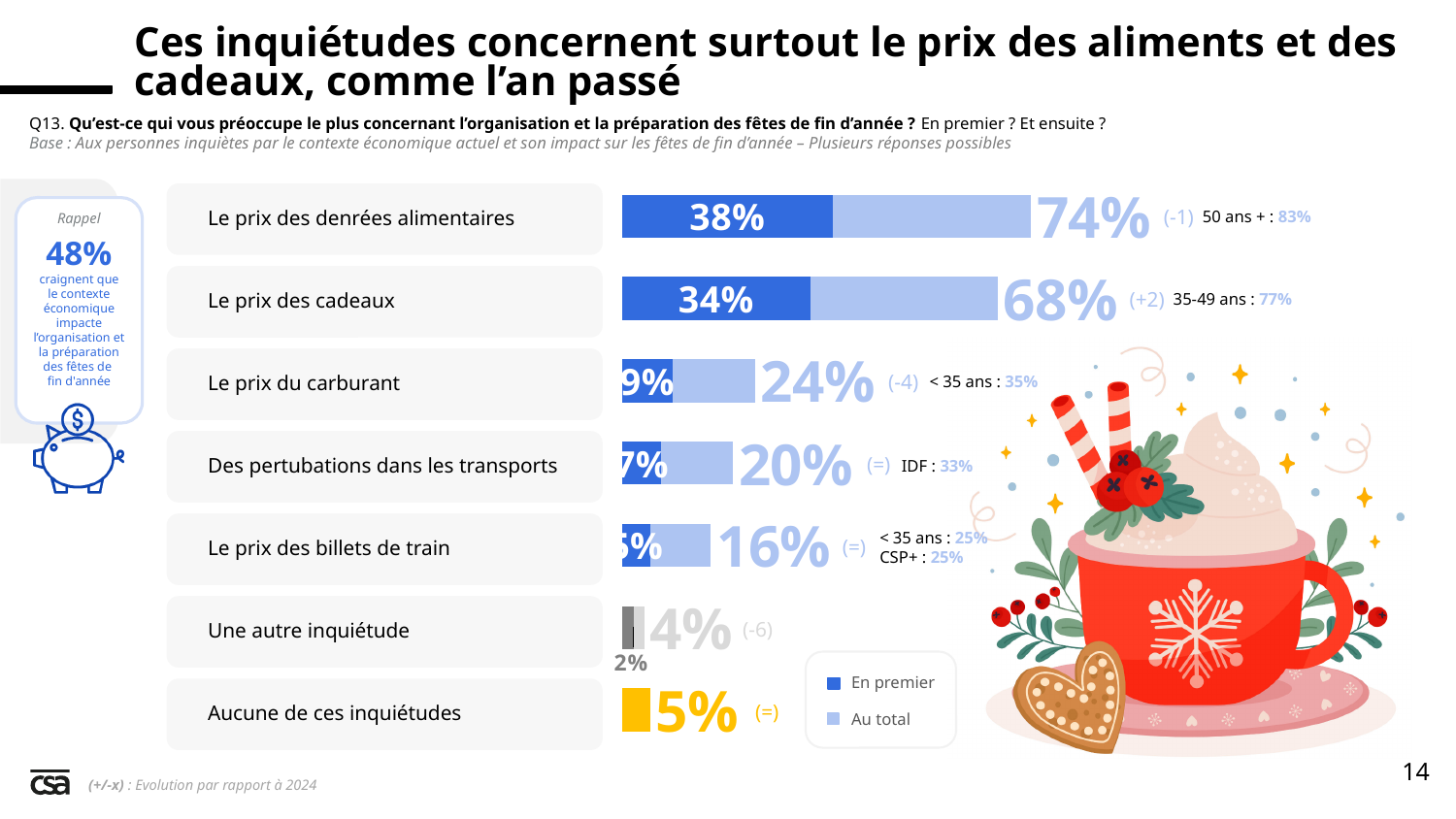
What is the 'En premier' value for 'Le prix des cadeaux'? 34% What kind of chart is shown on the slide? Bar chart What is the 'Au total' value for 'Le prix des denrées alimentaires'? 74% What is the difference between the 'Au total' values for 'Le prix des denrées alimentaires' and 'Le prix des cadeaux'? 6% What is the 'En premier' value for 'Des pertubations dans les transports'? 7% Which category has the highest 'Au total' value? Le prix des denrées alimentaires Which is larger: the 'Au total' value for 'Le prix du carburant' or for 'Des pertubations dans les transports'? Le prix du carburant How many series does the legend list? 2 How many categories are shown in the chart? 7 What are the two series named in the legend? En premier and Au total What is the 'Au total' value for 'Le prix du carburant'? 24% Which category has the lowest 'Au total' value? Une autre inquiétude